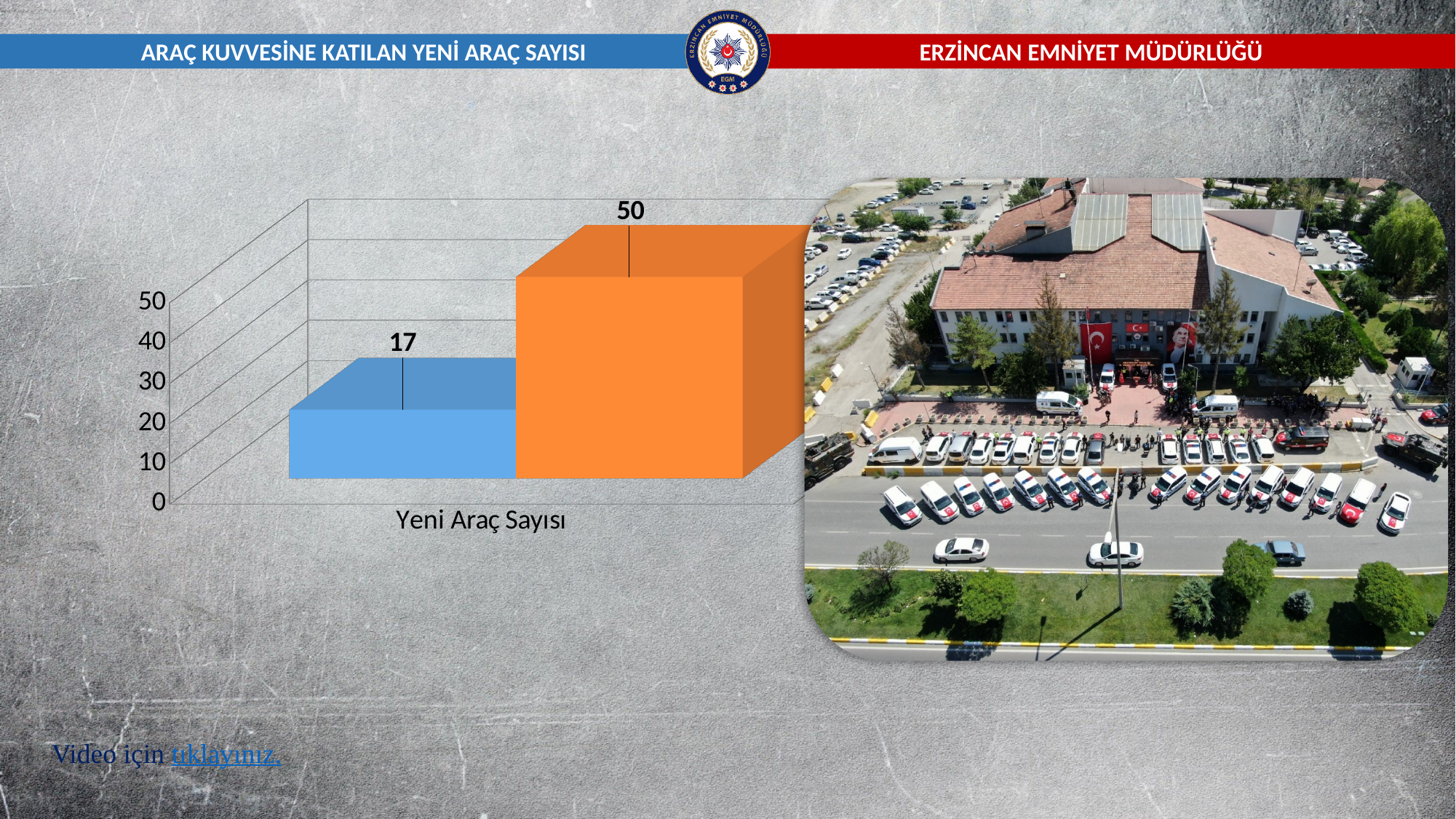
What kind of chart is shown on the slide? bar chart What is the difference between the orange bar's value and the blue bar's value? 33 How many bars are plotted in the chart? 2 What value is shown on the blue bar in the chart? 17 How many categories are shown on the x axis of the chart? 1 Which bar has the lower value, the blue one or the orange one? the blue bar What value is shown on the orange bar in the chart? 50 Is the value of the blue bar larger or smaller than the value of the orange bar? smaller What is the category label shown on the x axis of the chart? Yeni Araç Sayısı Is the value of the blue bar greater or less than 20? less Is the value of the orange bar greater or less than 40? greater Which bar has the higher value, the blue one or the orange one? the orange bar